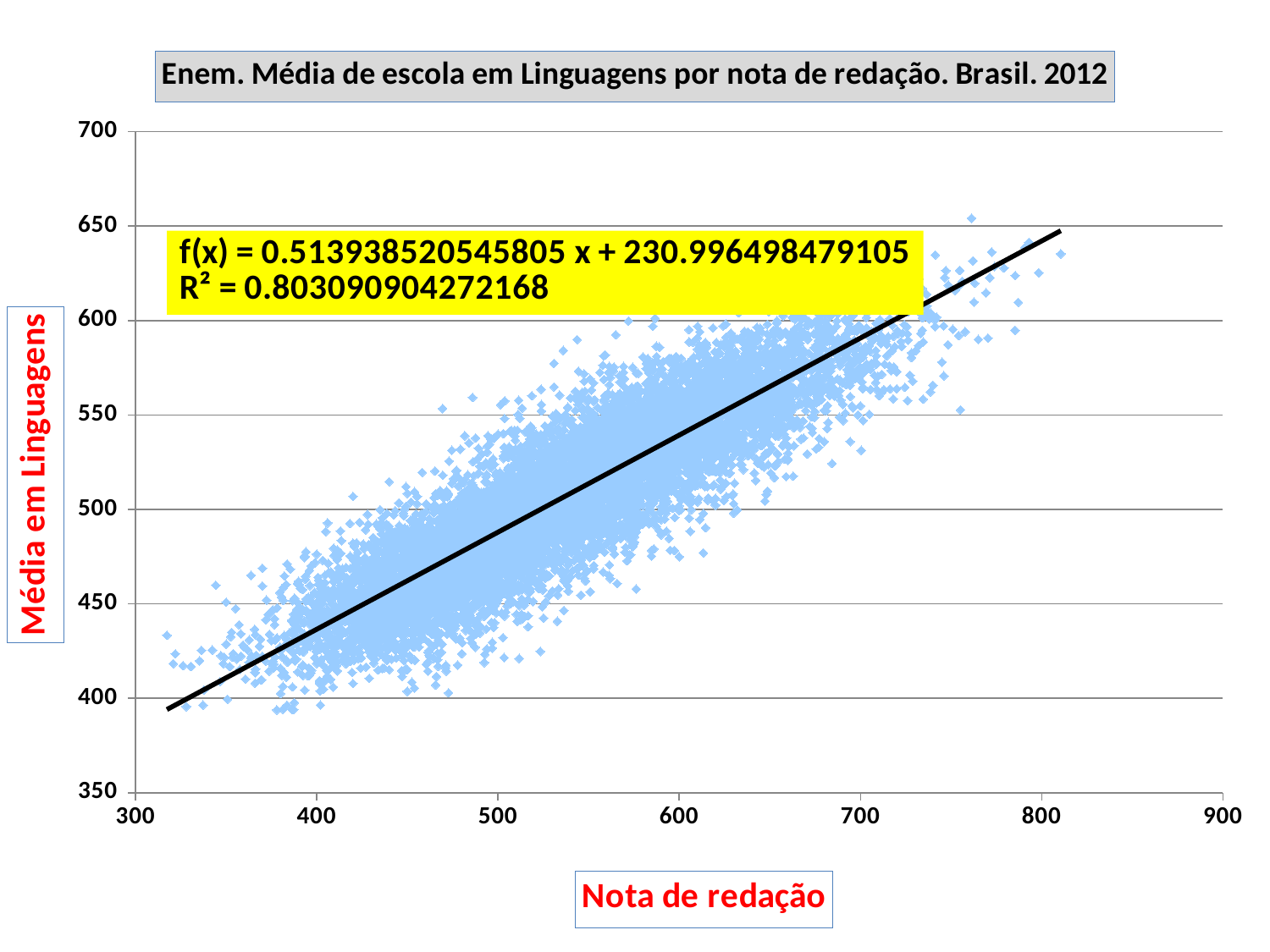
Do the values of Média em Linguagens rise or fall as Nota de redação increases along the x axis? Rise What is the intercept of the fitted line f(x) shown on the chart? 230.996498479105 What is the label of the x axis? Nota de redação What is the title of the chart? Enem. Média de escola em Linguagens por nota de redação. Brasil. 2012 What kind of chart is shown on the slide? Scatter plot What is the R² value printed on the chart? 0.803090904272168 Is the value of the fitted trend line at a Nota de redação of 400 greater or less than 450? less What is the slope of the fitted line f(x) shown on the chart? 0.513938520545805 Is the value of the fitted trend line at a Nota de redação of 700 greater or less than 550? greater